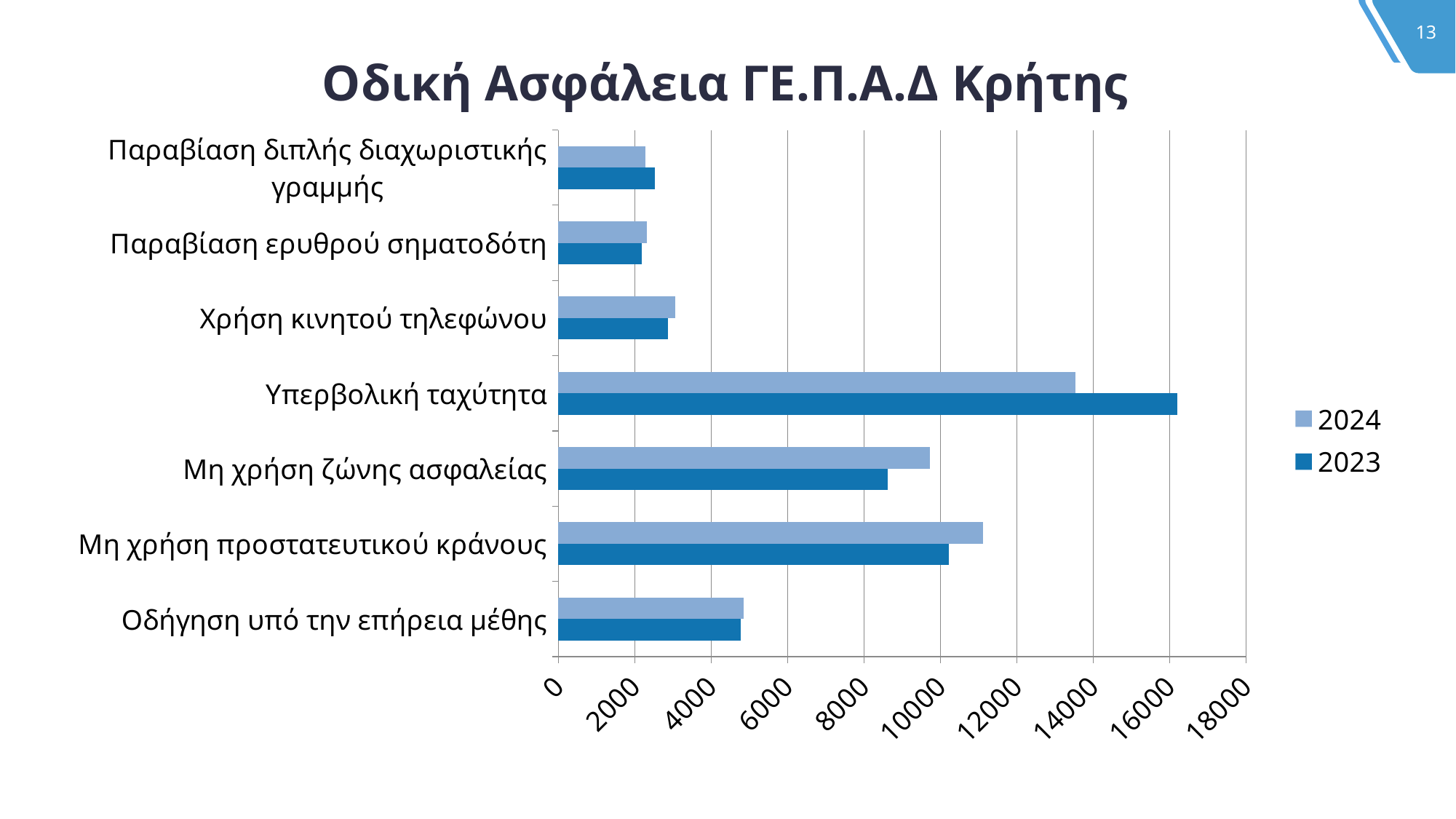
Which category has the highest value for 2024? Υπερβολική ταχύτητα How many categories are shown on the chart? 7 What is the title of the chart? Οδική Ασφάλεια ΓΕ.Π.Α.Δ Κρήτης How many series does the legend list? 2 For Μη χρήση ζώνης ασφαλείας, which year has the larger value, 2024 or 2023? 2024 Is the 2024 value for Μη χρήση προστατευτικού κράνους greater or less than 10000? greater For Υπερβολική ταχύτητα, which year has the larger value, 2024 or 2023? 2023 What kind of chart is shown on the slide? bar chart Is the 2024 value for Υπερβολική ταχύτητα greater or less than 14000? less Which category has the highest value for 2023? Υπερβολική ταχύτητα Which category has the lowest value for 2023? Παραβίαση ερυθρού σηματοδότη